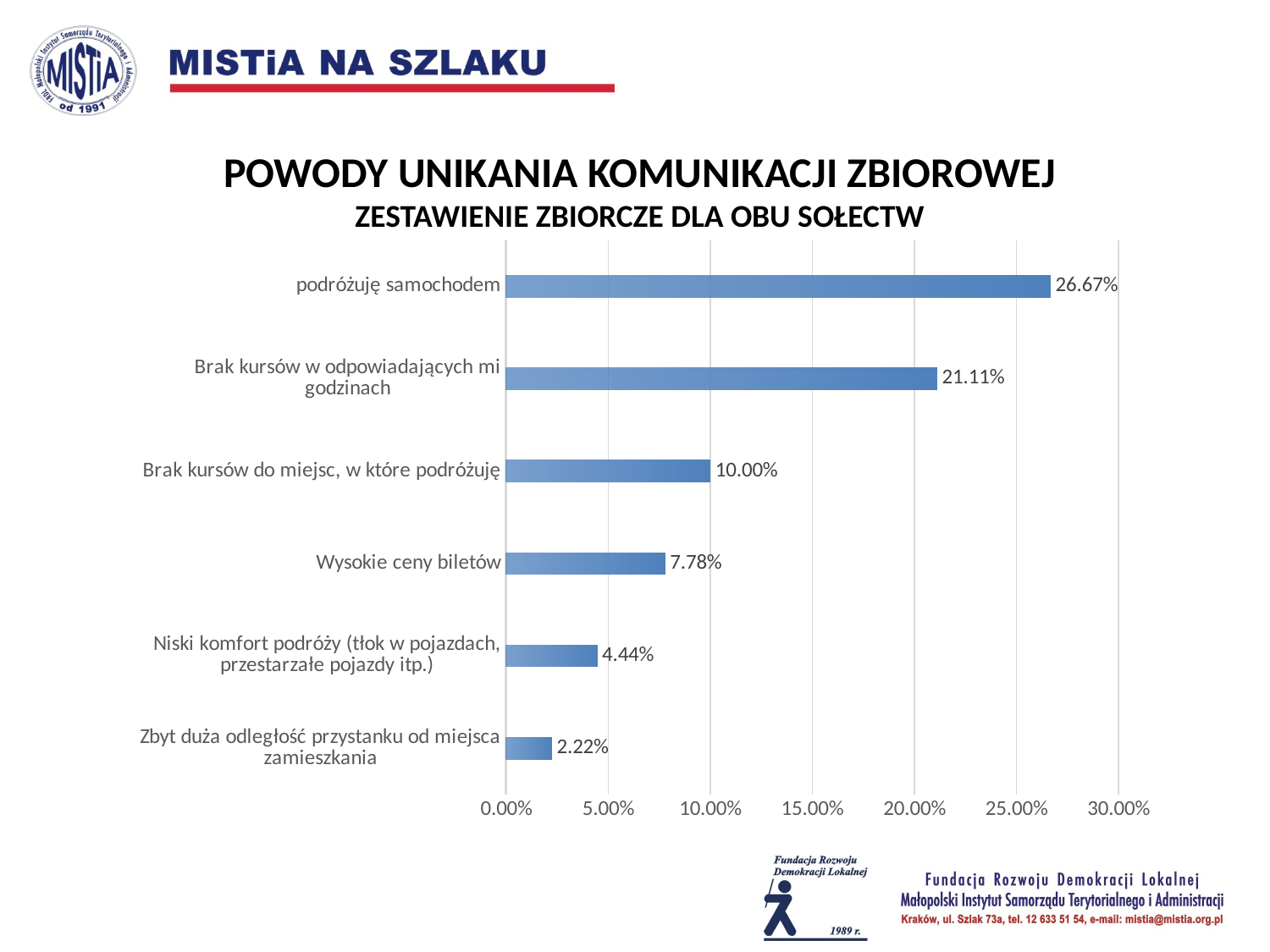
What is the value for "Zbyt duża odległość przystanku od miejsca zamieszkania"? 2.22% How many categories are shown in the chart? 6 Which is larger: the value for "Wysokie ceny biletów" or the value for "Niski komfort podróży (tłok w pojazdach, przestarzałe pojazdy itp.)"? Wysokie ceny biletów What kind of chart is shown on the slide? bar chart What is the difference between the values for "podróżuję samochodem" and "Brak kursów w odpowiadających mi godzinach"? 5.56% Which category has the highest value? podróżuję samochodem What is the subtitle of the chart below "POWODY UNIKANIA KOMUNIKACJI ZBIOROWEJ"? ZESTAWIENIE ZBIORCZE DLA OBU SOŁECTW Which category has the lowest value? Zbyt duża odległość przystanku od miejsca zamieszkania What is the value for "podróżuję samochodem"? 26.67% What is the value for "Wysokie ceny biletów"? 7.78% What is the value for "Brak kursów do miejsc, w które podróżuję"? 10.00% Is the value for "Brak kursów w odpowiadających mi godzinach" greater or less than 20.00%? greater